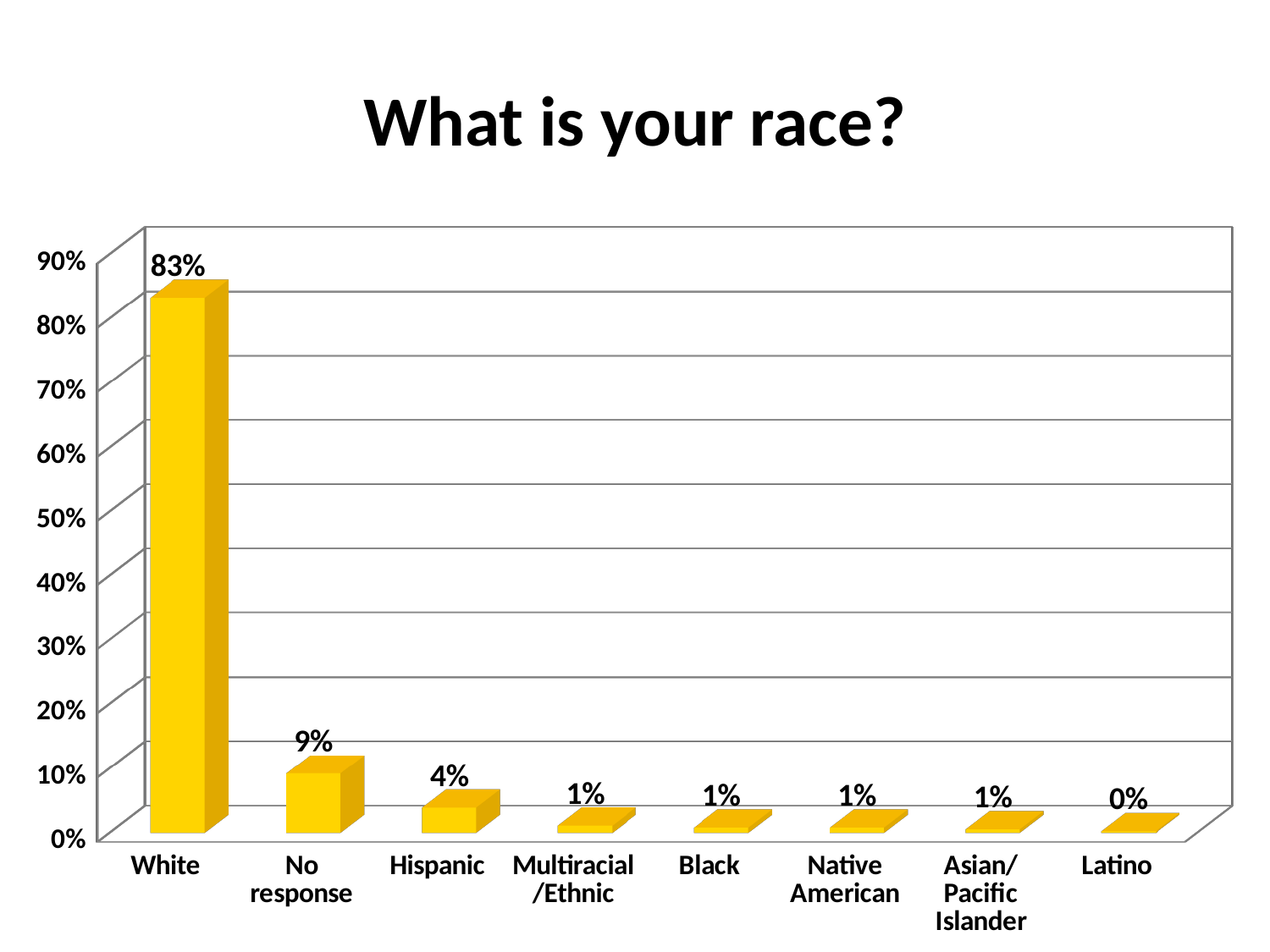
What kind of chart is shown on the slide? bar chart Which category has the highest value? White What is the value for White? 83% What is the difference between the values for No response and Hispanic? 5% What is the difference between the values for White and No response? 74% What is the value for Hispanic? 4% Which category has the lowest value? Latino What is the value for No response? 9% How many categories are shown on the x axis? 8 What is the value for Latino? 0% Is the value for White greater or less than 80%? greater Which is larger, the value for Hispanic or the value for No response? No response